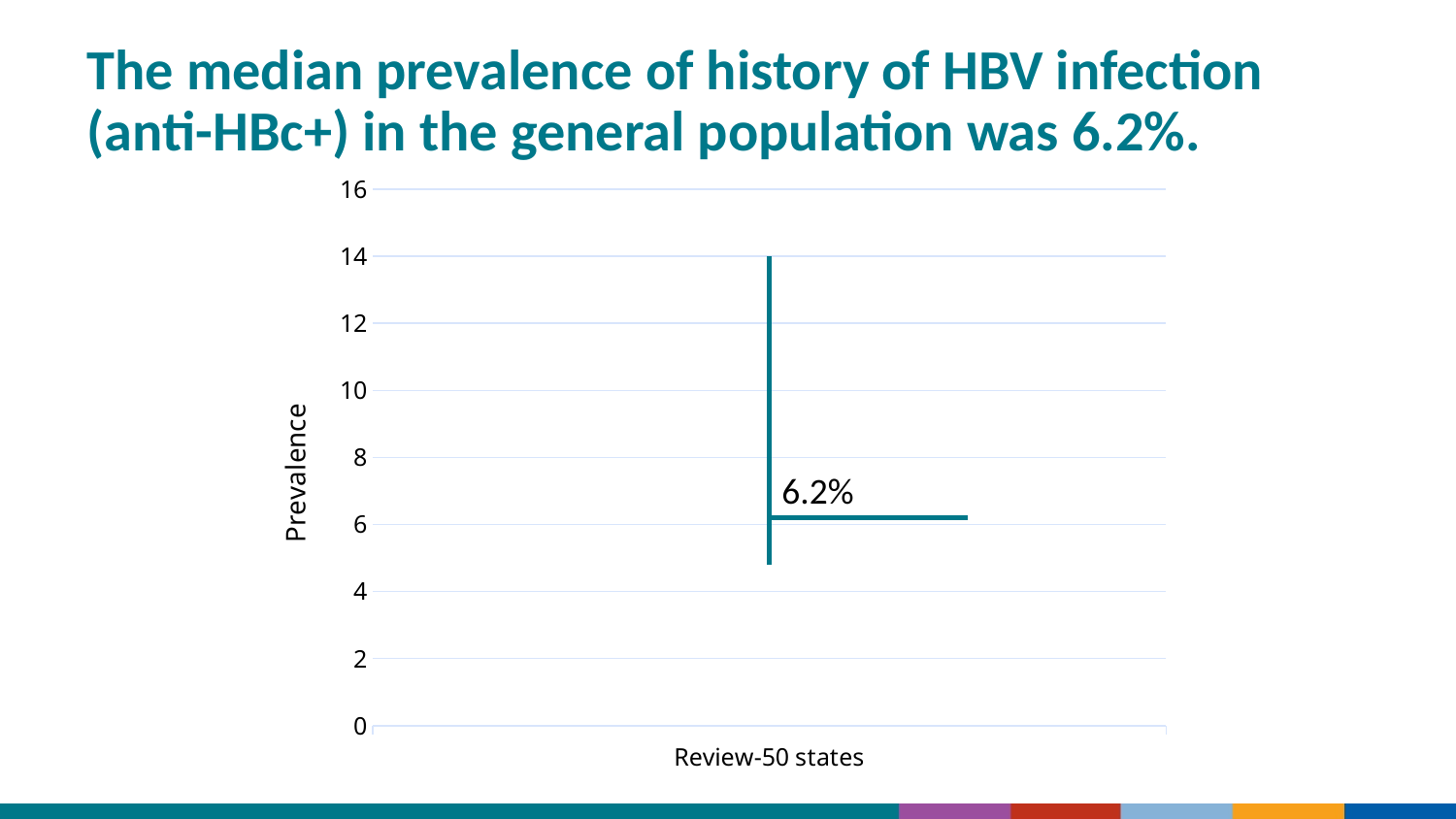
What is the maximum value shown on the y axis of the chart? 16 Is the top of the vertical range line for Review-50 states greater or less than 12? greater How many categories are plotted on the x axis of the chart? 1 Is the bottom of the vertical range line for Review-50 states greater or less than 6? less Is the median value for Review-50 states greater or less than 8? less What is the label on the x axis of the chart? Review-50 states What is the median prevalence value labelled on the chart? 6.2% What kind of chart is shown on the slide? high-low range chart What is the label on the y axis of the chart? Prevalence